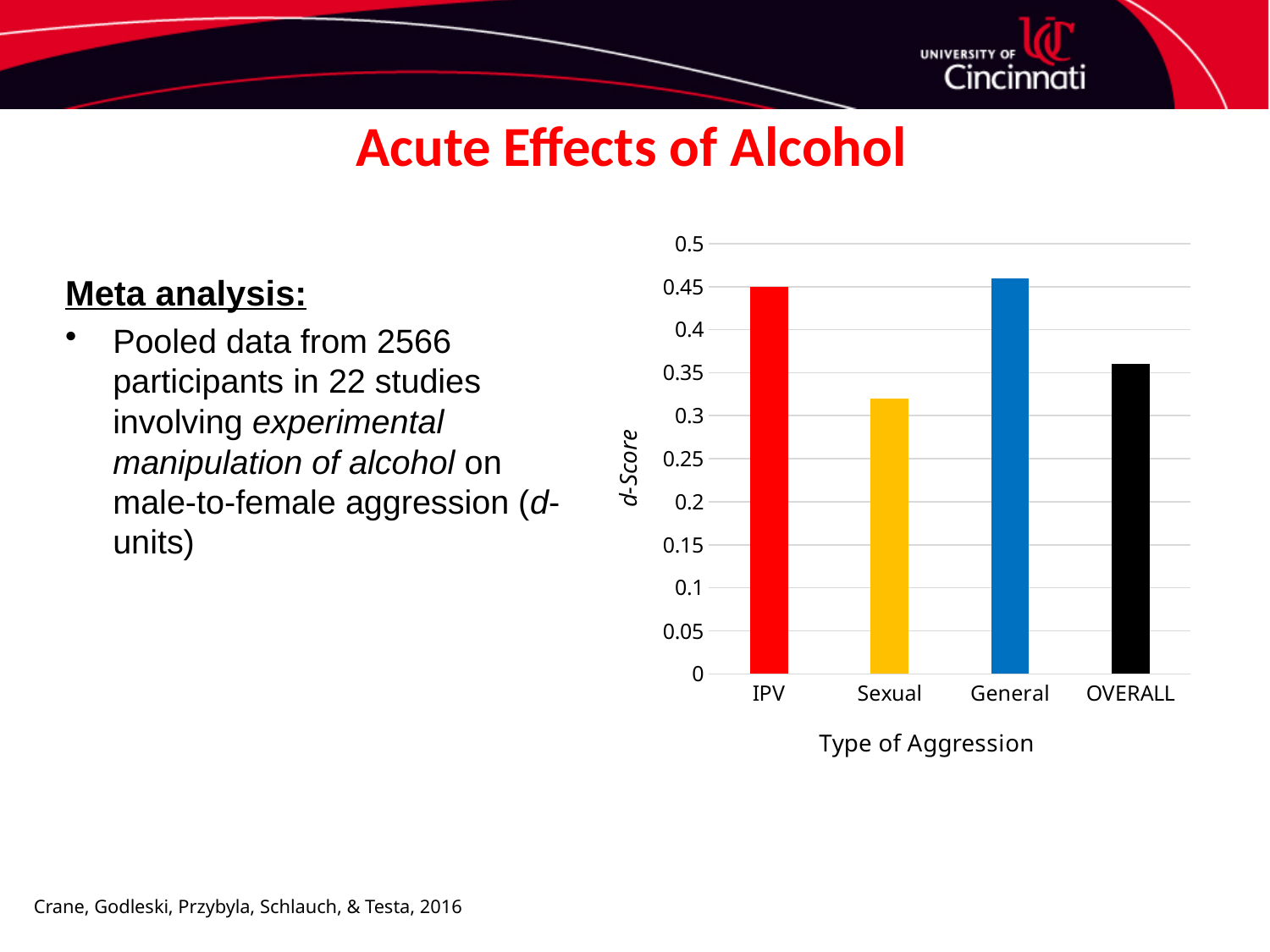
What is the d-Score for IPV? 0.45 Is the d-Score for General aggression greater or less than 0.4? greater Which has a higher d-Score, General aggression or OVERALL? General Which has a higher d-Score, IPV or Sexual aggression? IPV What colour is the bar for OVERALL? black What type of chart is shown on the slide? bar chart Which type of aggression has the lowest d-Score? Sexual Is the d-Score for Sexual aggression greater or less than 0.3? greater Is the d-Score for Sexual aggression greater or less than 0.35? less How many types of aggression are plotted on the chart? 4 What is the label on the vertical axis of the chart? d-Score